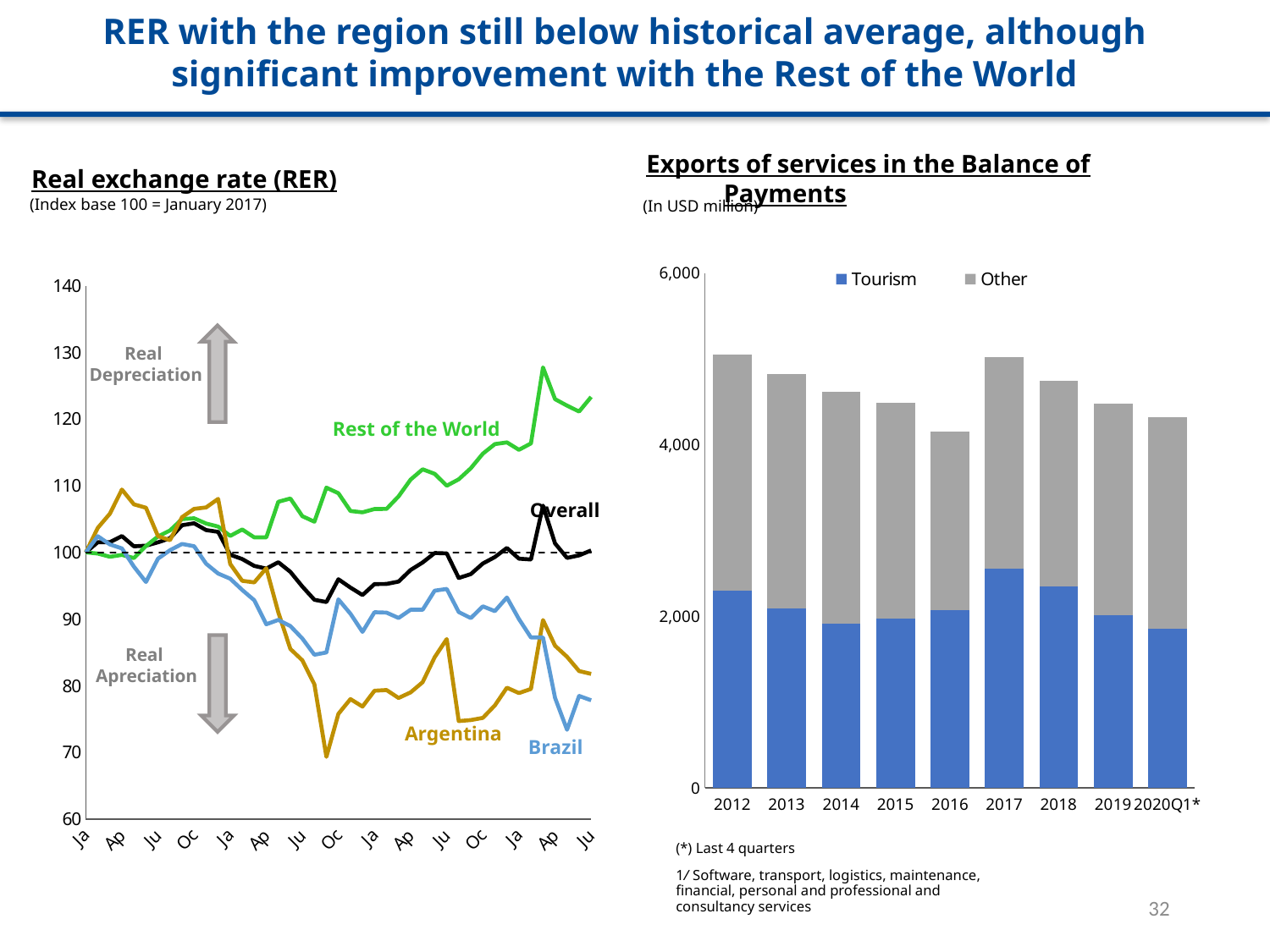
In the Exports of services in the Balance of Payments chart, how many series does the legend list? 2 In the Real exchange rate (RER) chart, which series is highest at the end of the period? Rest of the World In the Real exchange rate (RER) chart, is the peak value of the Rest of the World series greater or less than 120? greater In the Real exchange rate (RER) chart, what is the index base stated in the subtitle? 100 = January 2017 In the Exports of services in the Balance of Payments chart, which period has the lowest total bar? 2016 What kind of chart is the Exports of services in the Balance of Payments chart on the right? stacked bar chart In the Exports of services in the Balance of Payments chart, is the Tourism value for 2017 larger or smaller than the Tourism value for 2018? larger In the Exports of services in the Balance of Payments chart, which year has the highest Tourism value? 2017 In the Exports of services in the Balance of Payments chart, is the Tourism value for 2017 greater or less than 2,000? greater In the Exports of services in the Balance of Payments chart, is the total bar for 2016 greater or less than 4,000? greater What kind of chart is the Real exchange rate (RER) chart on the left? line chart In the Exports of services in the Balance of Payments chart, how many periods are shown on the x axis? 9